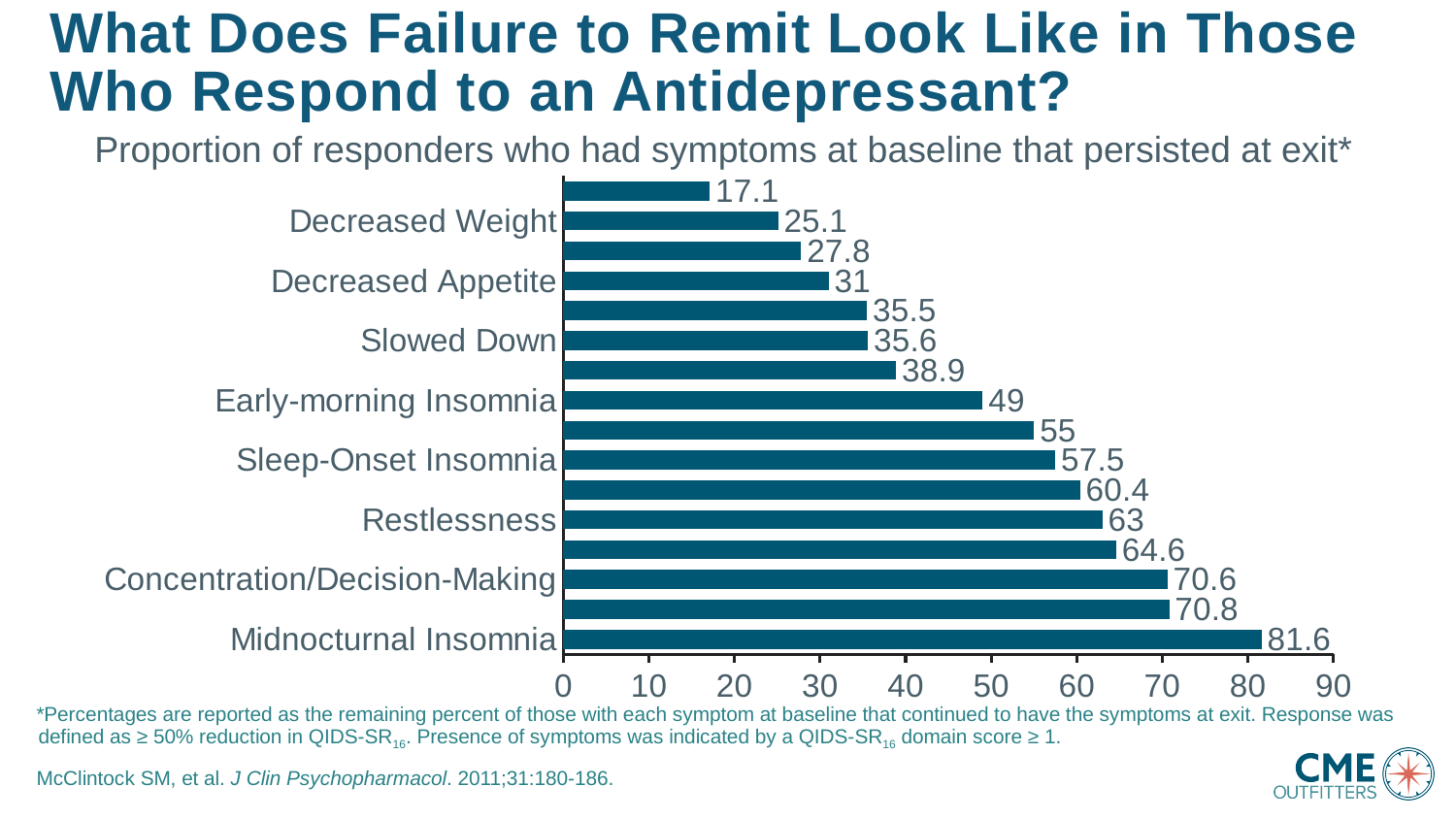
What is the value for Midnocturnal Insomnia? 81.6 Is the value for Restlessness greater or less than 60? greater How many bars are plotted on the chart? 16 What kind of chart is shown on the slide? bar chart What is the value for Decreased Weight? 25.1 What is the value for Concentration/Decision-Making? 70.6 What is the difference between the values for Restlessness and Decreased Appetite? 32 What is the value for Early-morning Insomnia? 49 What is the difference between the values for Midnocturnal Insomnia and Decreased Weight? 56.5 Which is larger, the value for Sleep-Onset Insomnia or the value for Slowed Down? Sleep-Onset Insomnia Which labeled category has the highest value? Midnocturnal Insomnia What is the lowest value shown on the chart? 17.1